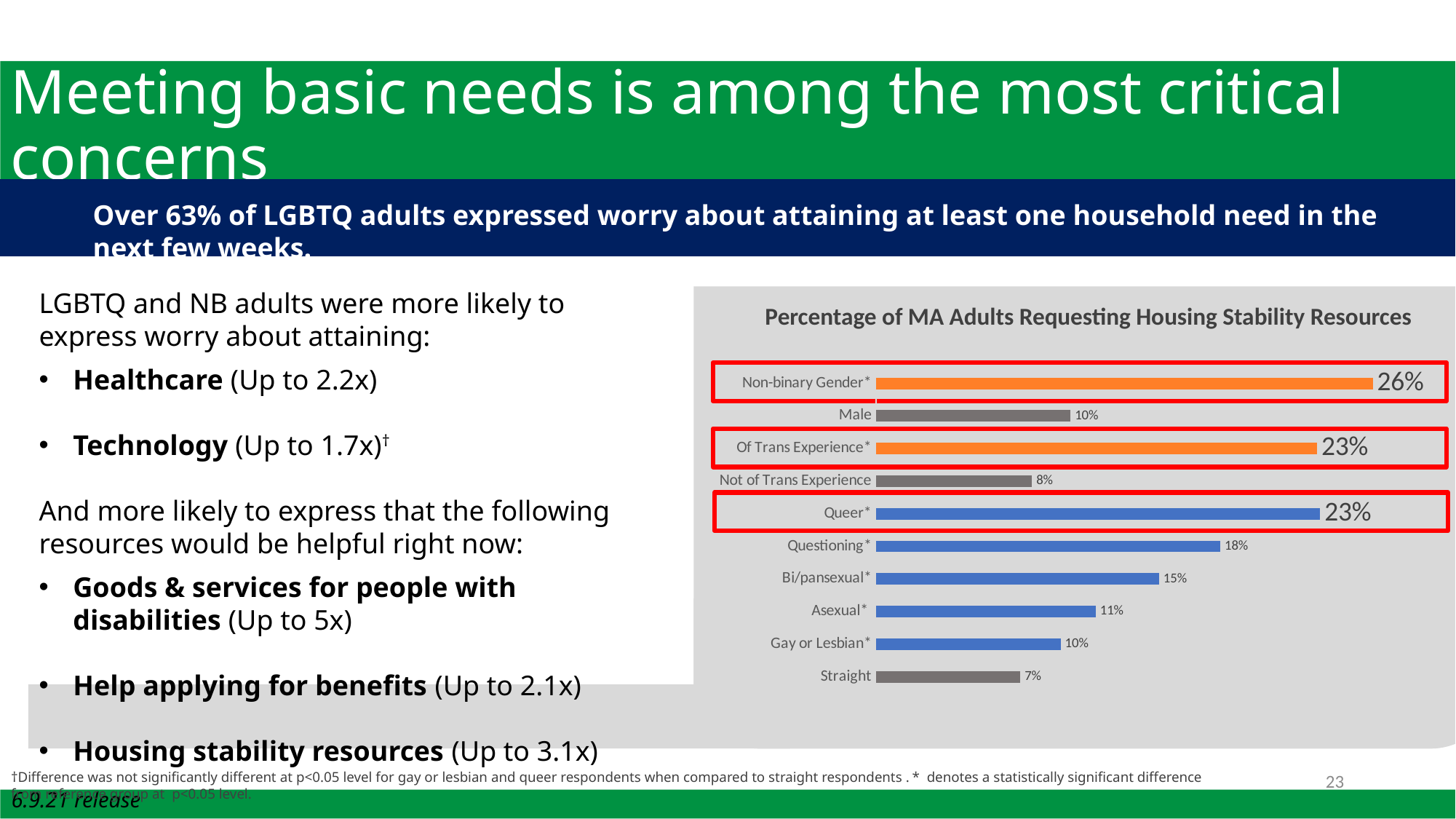
What is the value for Questioning in the chart? 18% What is the difference between the values for Non-binary Gender and Male? 16% What is the difference between the values for Queer and Straight? 16% What percentage of Straight adults requested housing stability resources? 7% What kind of chart is shown on the slide? Bar chart Which is larger, the value for Of Trans Experience or the value for Not of Trans Experience? Of Trans Experience What is the title of the chart? Percentage of MA Adults Requesting Housing Stability Resources Which category has the lowest value in the chart? Straight Which category has the highest value in the chart? Non-binary Gender How many categories are shown in the chart? 10 Which is larger, the value for Bi/pansexual or the value for Asexual? Bi/pansexual What is the value for Non-binary Gender in the chart? 26%